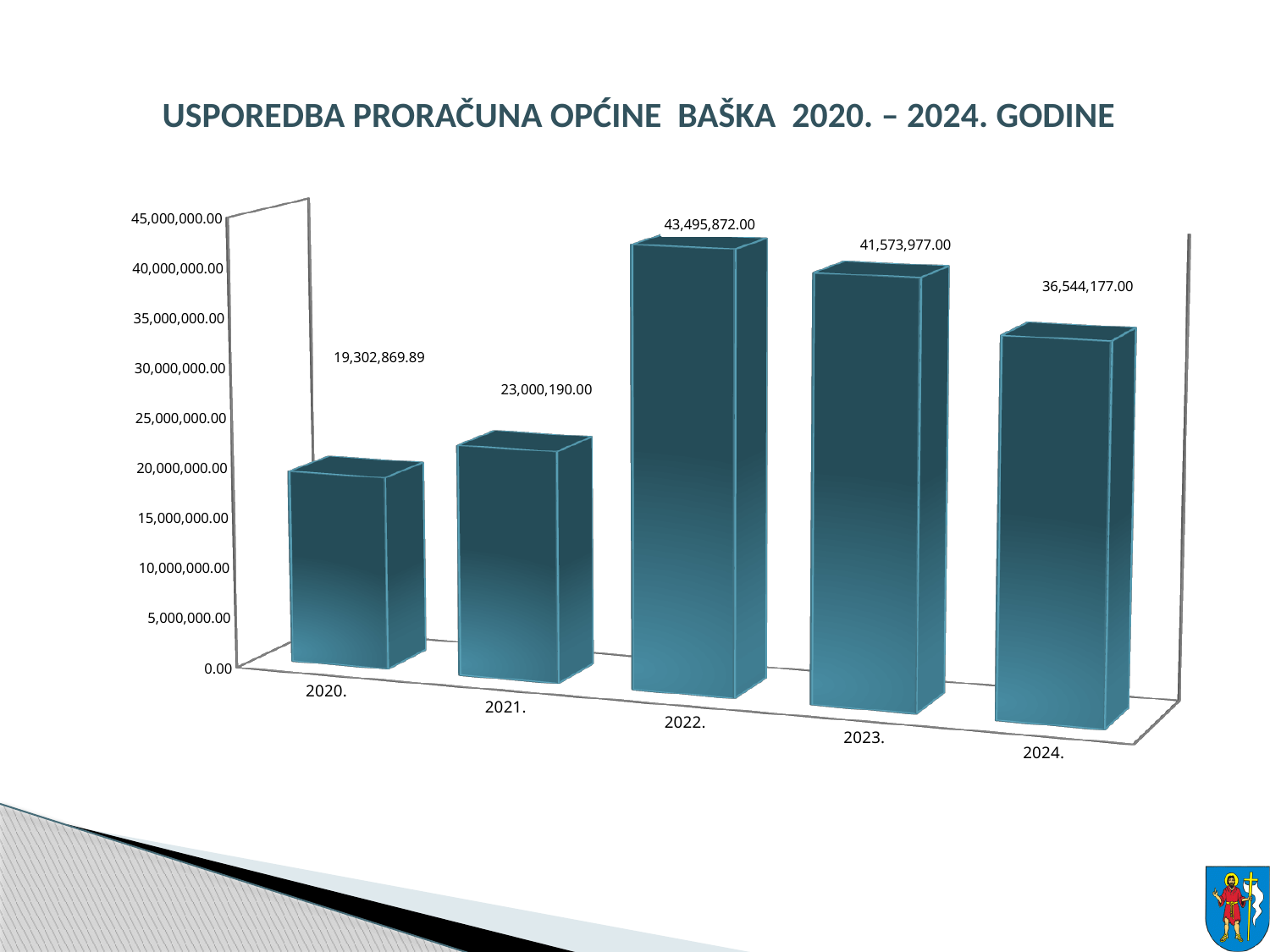
What is the value for 2024. in the chart? 36,544,177.00 Which year has the highest value in the chart? 2022. Which year has the lowest value in the chart? 2020. What is the value for 2022. in the chart? 43,495,872.00 Which is larger, the value for 2021. or the value for 2024.? 2024. How many years are shown in the chart? 5 What is the difference between the values for 2022. and 2023.? 1,921,895.00 What kind of chart is shown on the slide? bar chart Do the values rise or fall from 2022. to 2024.? fall What is the value for 2020. in the chart? 19,302,869.89 What is the difference between the values for 2023. and 2024.? 5,029,800.00 Is the value for 2023. greater or less than 40,000,000.00? greater